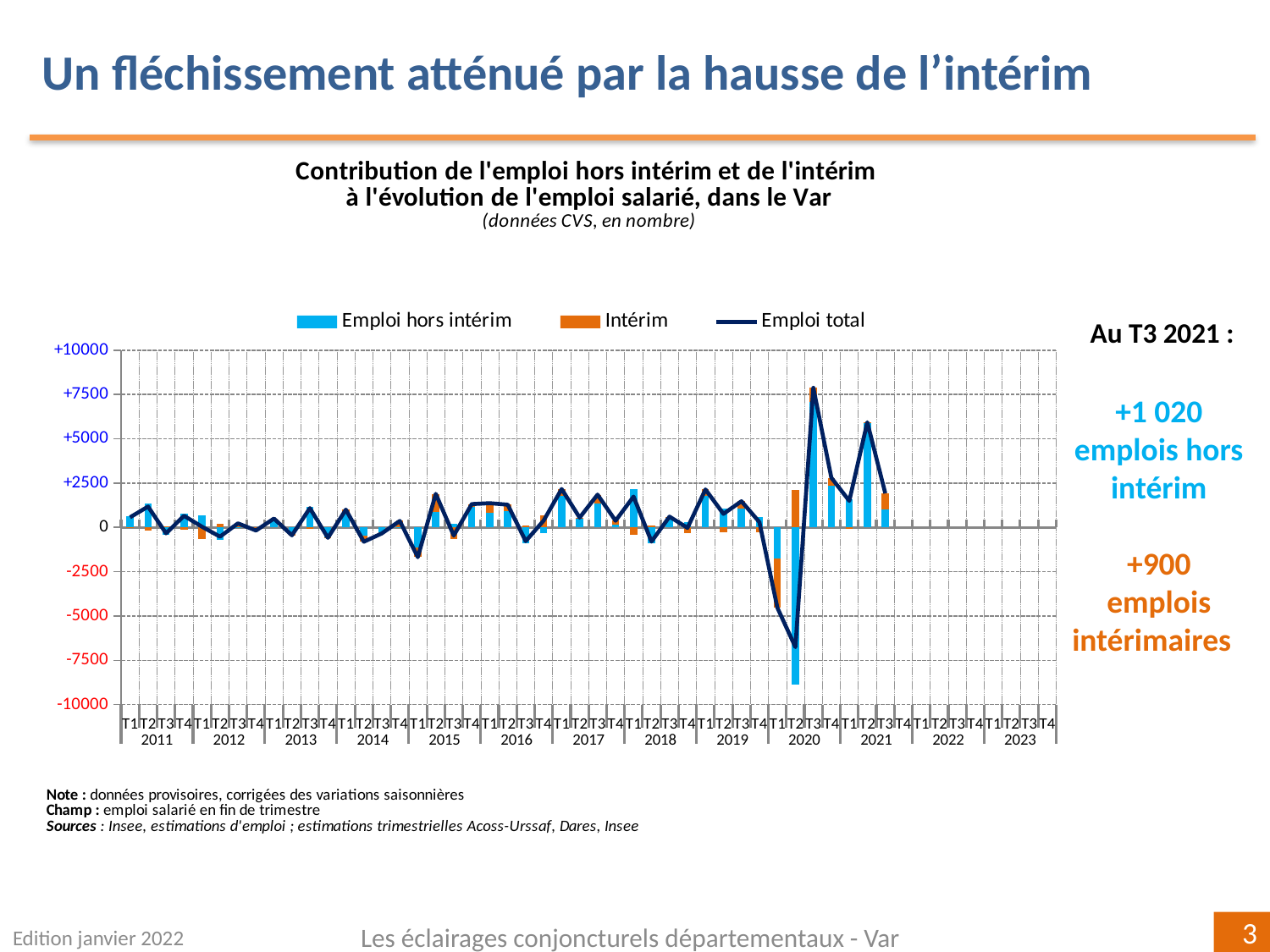
Which colour represents the 'Intérim' series in the chart? Orange Is the 'Emploi hors intérim' bar for T2 2020 greater or less than -7500? less What kind of chart is shown on the slide? A combined bar and line chart What is the difference between the 'Emploi hors intérim' contribution (+1 020) and the 'Intérim' contribution (+900) at T3 2021? 120 According to the slide, what is the contribution of 'Intérim' at T3 2021? +900 In which quarter does the 'Emploi total' line reach its highest point? T3 2020 Is the 'Emploi total' value for T3 2020 greater or less than +5000? greater In which quarter does the 'Emploi total' line reach its lowest point? T2 2020 How many series does the chart legend list? 3 At T3 2021, which contribution is larger: 'Emploi hors intérim' or 'Intérim'? Emploi hors intérim According to the slide, what is the contribution of 'Emploi hors intérim' at T3 2021? +1 020 Does the 'Emploi total' line rise or fall between T2 2020 and T3 2020? rise